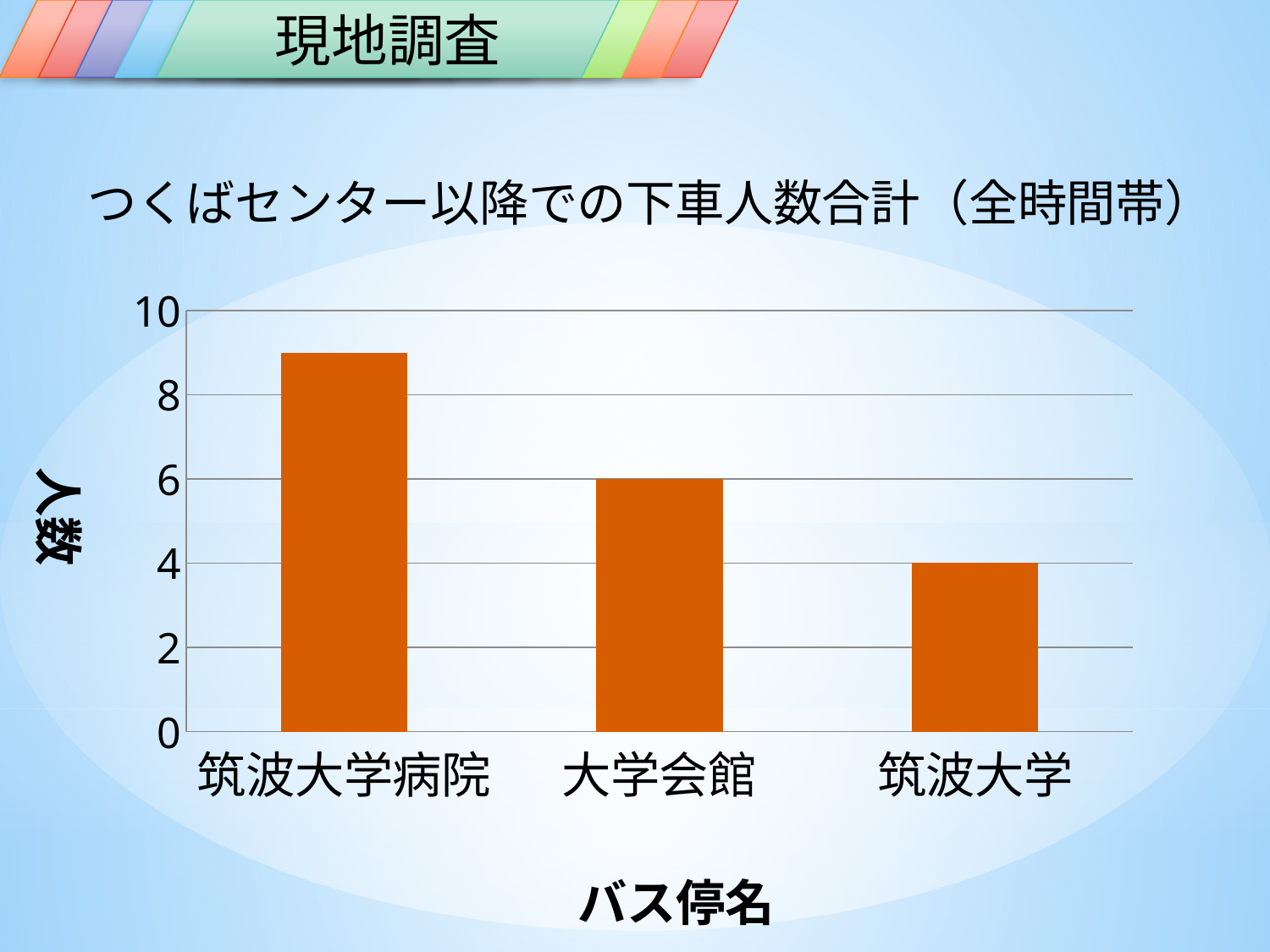
Which is larger, the value for 大学会館 or the value for 筑波大学? 大学会館 How many bus stops (categories) are shown on the x axis? 3 Which bus stop has the lowest number of people getting off? 筑波大学 Do the values rise or fall from left to right along the x axis? fall What is the value for 大学会館? 6 What kind of chart is shown on the slide? bar chart Which bus stop has the highest number of people getting off? 筑波大学病院 What is the value for 筑波大学? 4 Is the value for 筑波大学病院 greater or less than 10? less Is the value for 筑波大学病院 greater or less than 8? greater What is the label of the x axis? バス停名 What is the difference between the values for 大学会館 and 筑波大学? 2